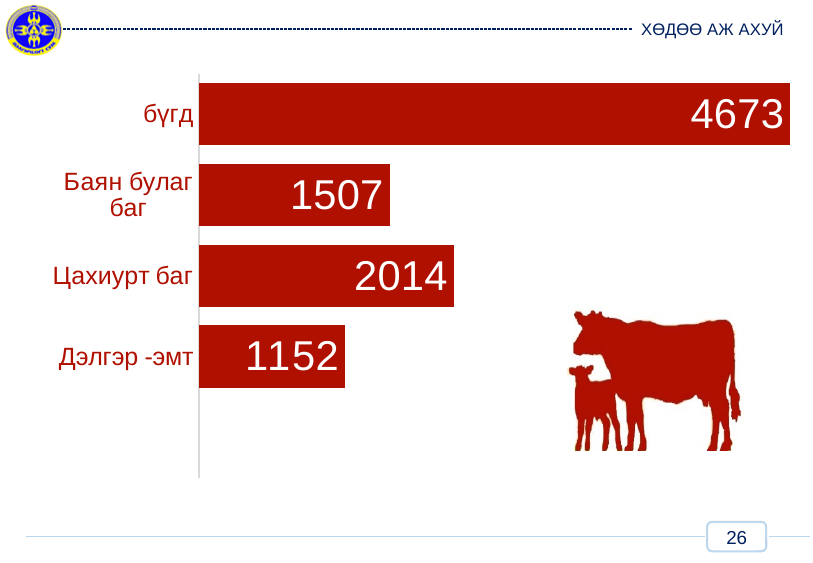
Which is larger, the value for Баян булаг баг or the value for Дэлгэр -эмт? Баян булаг баг What is the value for Баян булаг баг? 1507 What is the difference between the values for Цахиурт баг and Баян булаг баг? 507 Which category has the highest value? бүгд Which category has the lowest value? Дэлгэр -эмт What is the value for Цахиурт баг? 2014 What colour are the bars in the chart? red What kind of chart is shown on the slide? bar chart What is the value for бүгд? 4673 What is the difference between the values for бүгд and Дэлгэр -эмт? 3521 How many categories are shown in the chart? 4 What is the value for Дэлгэр -эмт? 1152